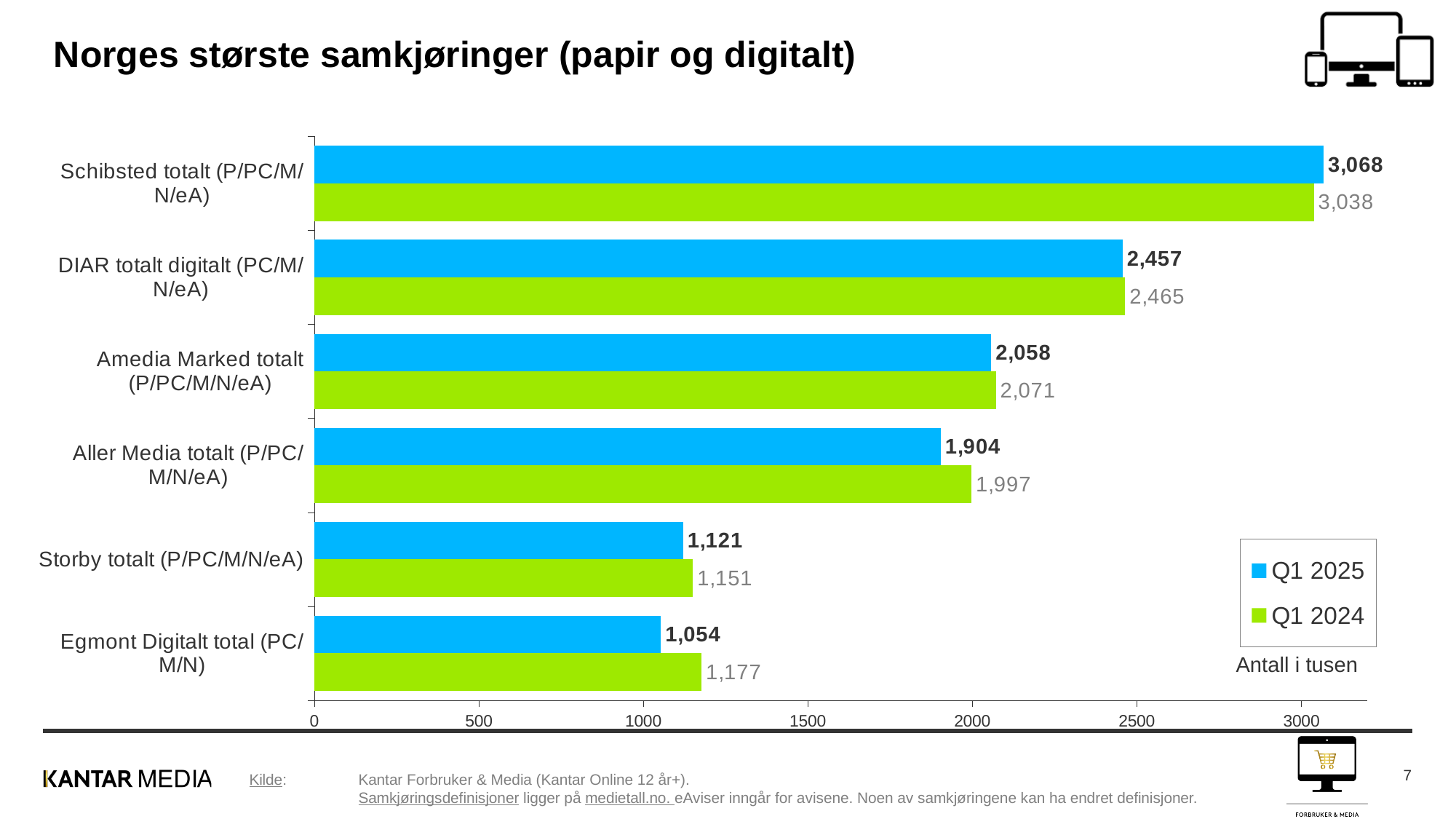
Which category has the lowest Q1 2024 value? Storby totalt (P/PC/M/N/eA) How many series does the legend list? 2 What is the Q1 2024 value for Egmont Digitalt total (PC/M/N)? 1,177 Is the Q1 2025 value for DIAR totalt digitalt (PC/M/N/eA) greater or less than 2500? less What is the difference between the Q1 2024 and Q1 2025 values for Aller Media totalt (P/PC/M/N/eA)? 93 How many categories are shown in the chart? 6 Which category has the highest Q1 2025 value? Schibsted totalt (P/PC/M/N/eA) For Egmont Digitalt total (PC/M/N), which is larger: the Q1 2025 value or the Q1 2024 value? Q1 2024 What is the Q1 2025 value for Aller Media totalt (P/PC/M/N/eA)? 1,904 What unit note is shown below the legend? Antall i tusen What kind of chart is shown on the slide? bar chart What is the Q1 2025 value for Schibsted totalt (P/PC/M/N/eA)? 3,068